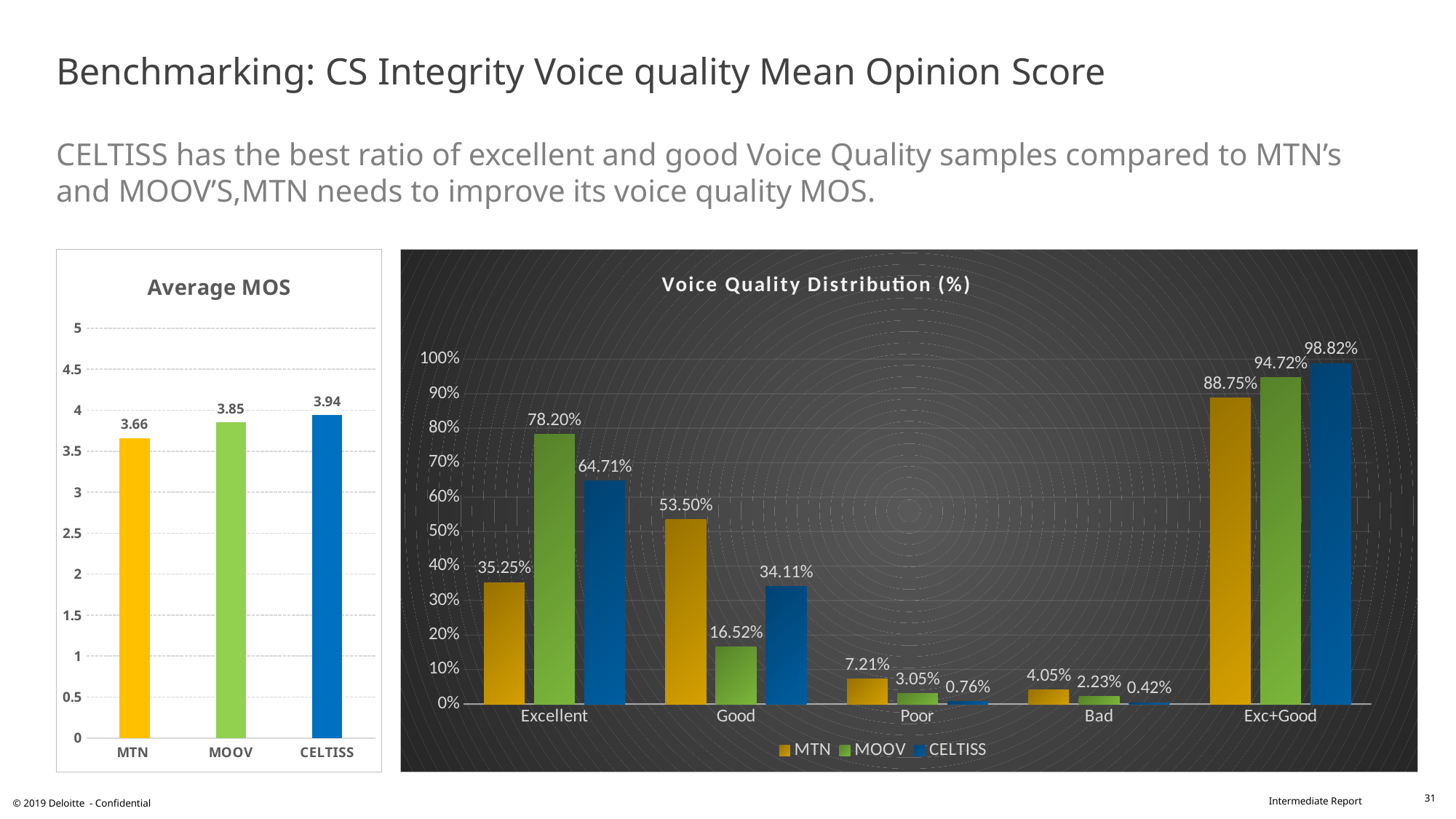
In the Voice Quality Distribution (%) chart, which operator has the lowest value in the Bad category? CELTISS In the Average MOS chart, what is the difference between CELTISS and MTN? 0.28 In the Average MOS chart, how many operators are shown? 3 In the Voice Quality Distribution (%) chart, what is the value for CELTISS in the Good category? 34.11% In the Voice Quality Distribution (%) chart, which is larger in the Good category, MTN or MOOV? MTN In the Average MOS chart, which operator has the highest average MOS? CELTISS In the Voice Quality Distribution (%) chart, what is the difference between CELTISS and MTN in the Exc+Good category? 10.07% In the Average MOS chart, what is the value for MTN? 3.66 What kind of chart is the Voice Quality Distribution (%) chart? Bar chart In the Voice Quality Distribution (%) chart, what is the value for MOOV in the Excellent category? 78.20% In the Voice Quality Distribution (%) chart, how many series does the legend list? 3 In the Voice Quality Distribution (%) chart, how many categories are shown on the x axis? 5